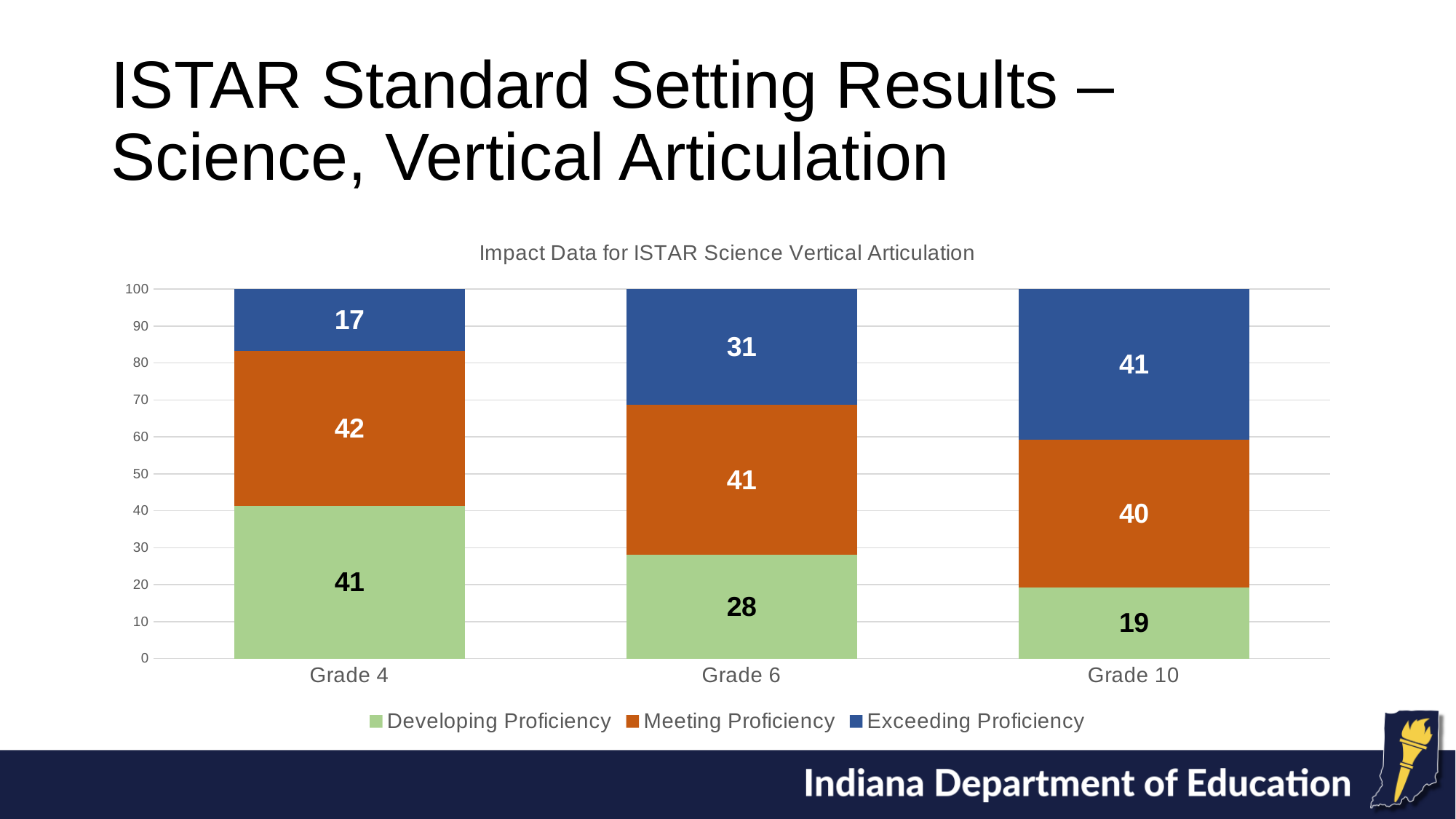
What kind of chart is shown on the slide? Stacked bar chart What is the Meeting Proficiency value for Grade 10? 40 Does the Developing Proficiency value rise or fall from Grade 4 to Grade 10? Fall How many series does the legend list? 3 What is the Developing Proficiency value for Grade 4? 41 Which grade has the highest Exceeding Proficiency value? Grade 10 How many grade categories are shown on the x axis? 3 Which grade has the lowest Developing Proficiency value? Grade 10 What is the difference between the Exceeding Proficiency values for Grade 10 and Grade 4? 24 Which is larger: the Developing Proficiency value for Grade 6 or the Exceeding Proficiency value for Grade 6? Exceeding Proficiency for Grade 6 What is the total of the stacked bar for Grade 6? 100 What is the Exceeding Proficiency value for Grade 6? 31